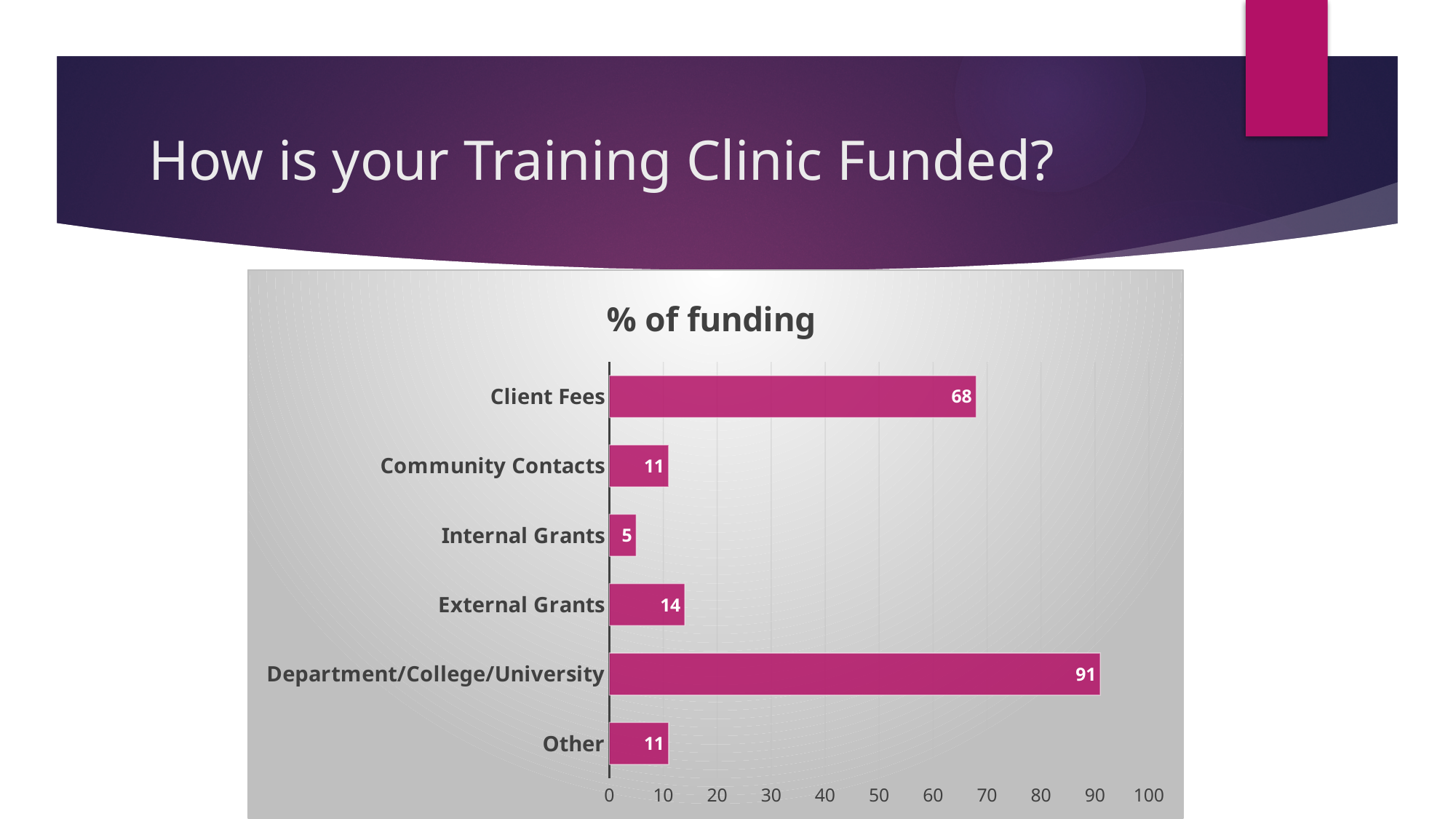
Is the value for Client Fees greater or less than 60? greater Which category has the highest value? Department/College/University What is the value for Internal Grants? 5 What is the value for Client Fees? 68 How many categories are shown in the chart? 6 What is the value for External Grants? 14 What is the title of the chart? % of funding What kind of chart is shown on the slide? bar chart Which is larger, the value for External Grants or the value for Community Contacts? External Grants What is the difference between the values for Department/College/University and Client Fees? 23 Which category has the lowest value? Internal Grants What is the value for Department/College/University? 91